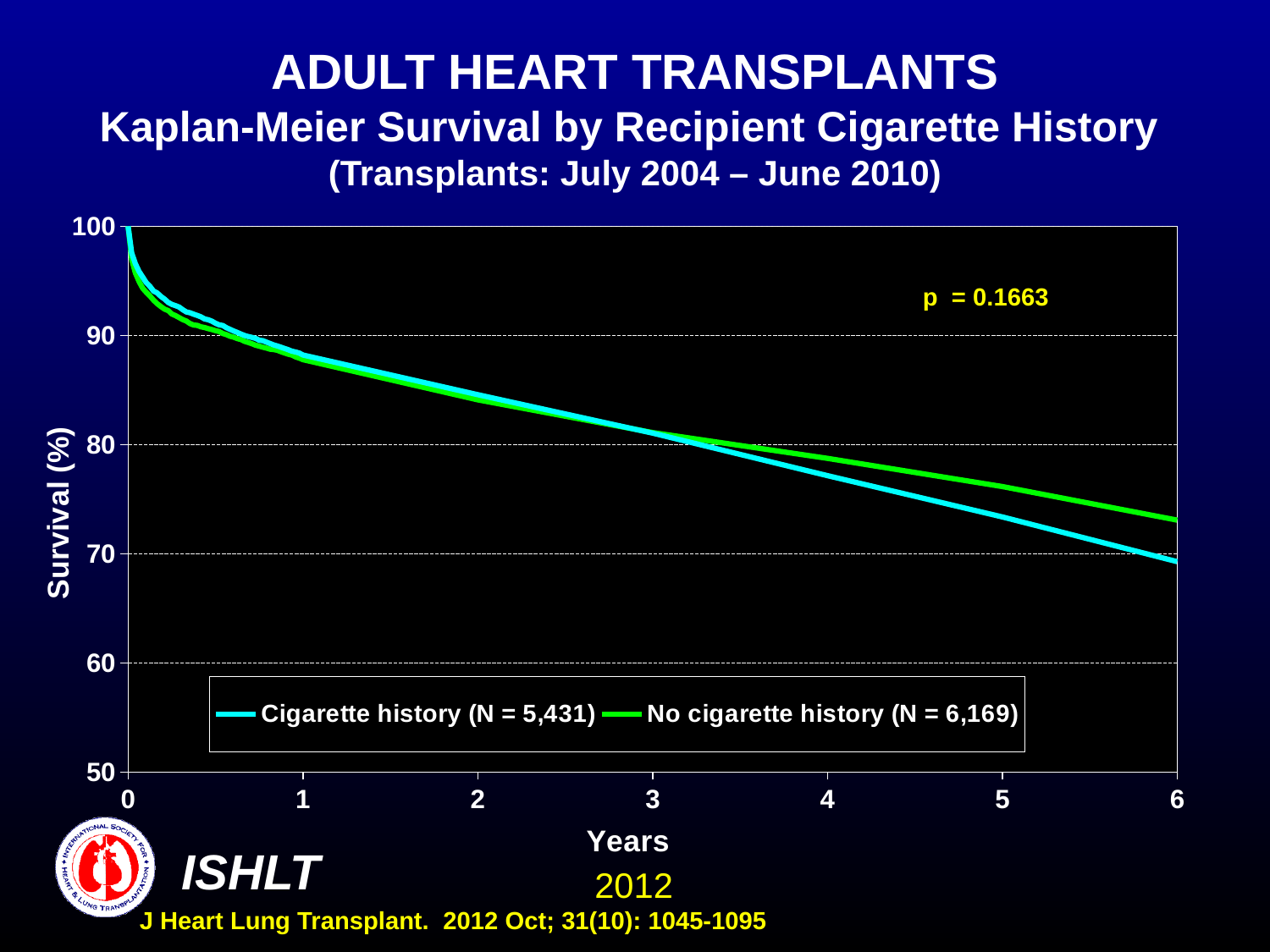
Is the survival value for No cigarette history at 6 years greater or less than 70? greater Is the survival value for Cigarette history at 6 years greater or less than 70? less What is the label of the y axis? Survival (%) What is the N for the No cigarette history group shown in the legend? 6,169 At 6 years, which group has the higher survival: Cigarette history or No cigarette history? No cigarette history Is the survival value for Cigarette history at 1 year greater or less than 90? less What is the N for the Cigarette history group shown in the legend? 5,431 What kind of chart is shown on the slide? line chart What p-value is printed on the chart? p = 0.1663 How many series does the legend list? 2 Do the survival curves rise or fall as years increase? fall